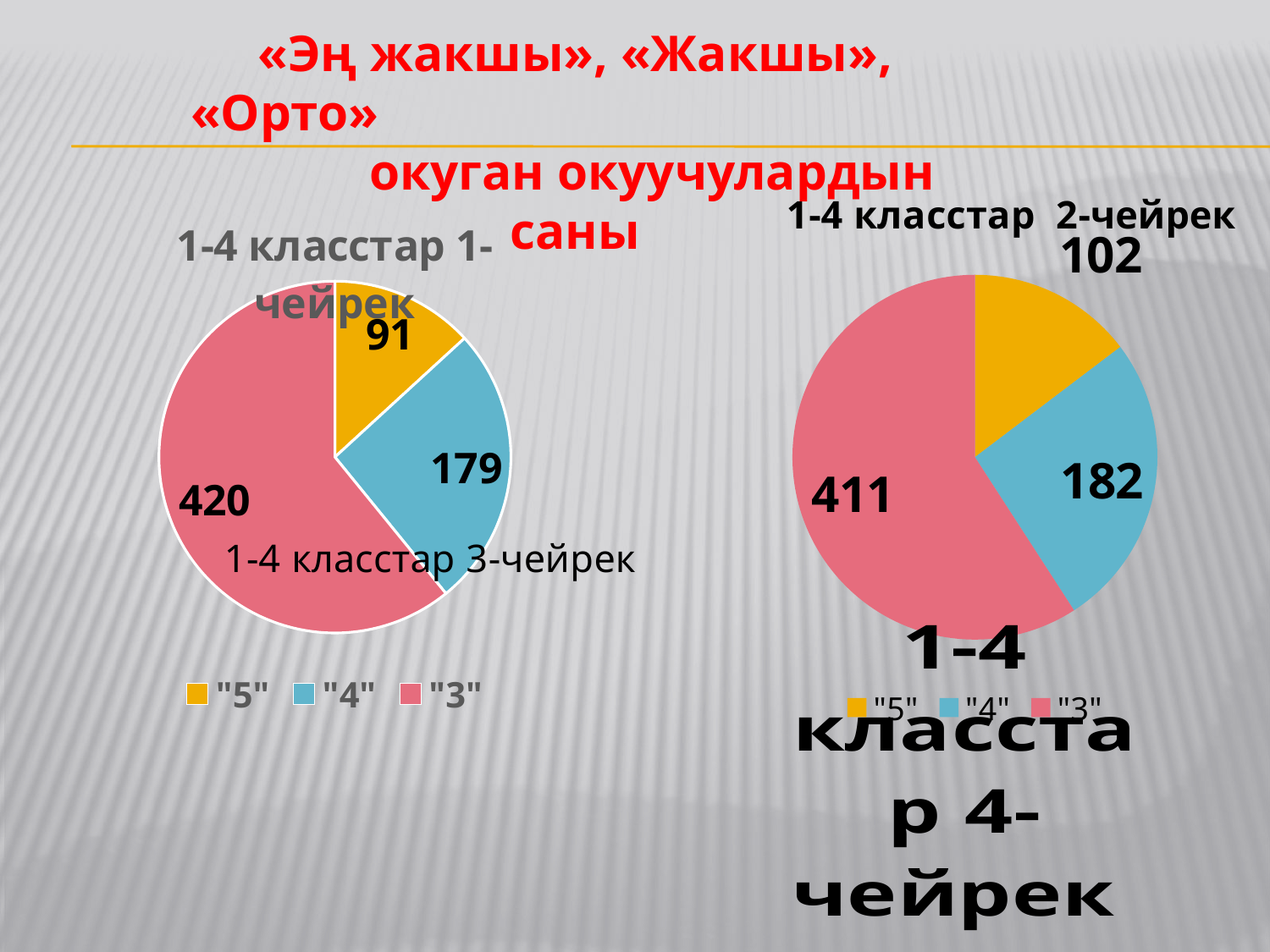
In the left pie chart (1-4 класстар 1-чейрек), what is the value for the "5" slice? 91 In the left pie chart (1-4 класстар 1-чейрек), which category has the smallest slice? "5" In the left pie chart (1-4 класстар 1-чейрек), what is the difference between the "3" slice and the "4" slice? 241 What type of chart is the left chart titled "1-4 класстар 1-чейрек"? pie chart In the left pie chart (1-4 класстар 1-чейрек), what is the value for the "4" slice? 179 In the right pie chart (1-4 класстар 2-чейрек), what is the value for the "3" slice? 411 In the left pie chart (1-4 класстар 1-чейрек), which category has the largest slice? "3" In the right pie chart (1-4 класстар 2-чейрек), which is larger, the "4" slice or the "5" slice? "4" What colour is the "3" slice in the legend of the left pie chart? pink/red In the right pie chart (1-4 класстар 2-чейрек), what is the value for the "5" slice? 102 In the right pie chart (1-4 класстар 2-чейрек), what is the total of all three slices? 695 How many slices does the left pie chart (1-4 класстар 1-чейрек) have? 3